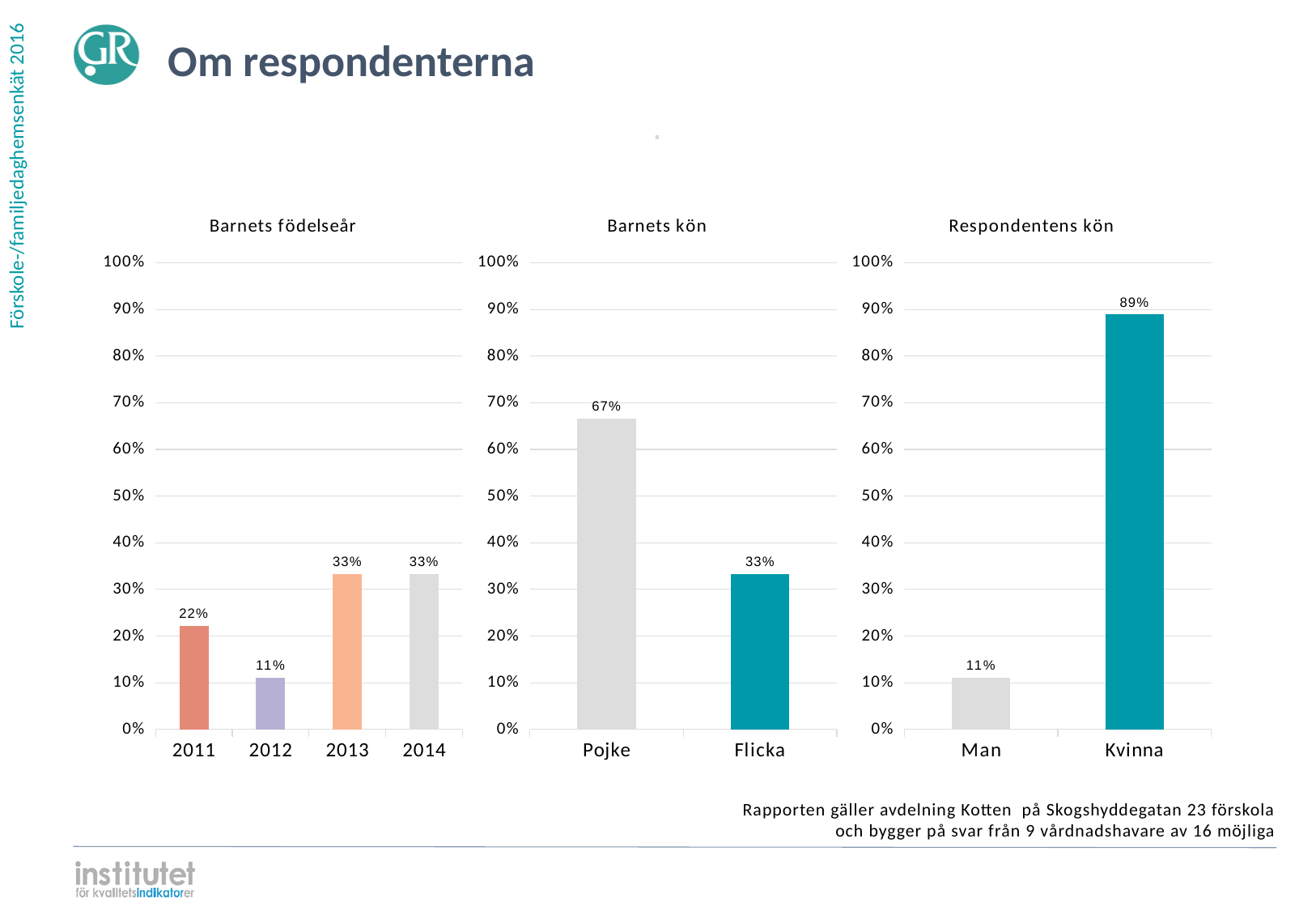
In the 'Barnets födelseår' chart, what is the difference between the values for 2013 and 2012? 22% In the 'Respondentens kön' chart, what is the value for Kvinna? 89% In the 'Barnets kön' chart, what is the difference between Pojke and Flicka? 34% In the 'Barnets kön' chart, which category is higher, Pojke or Flicka? Pojke In the 'Barnets födelseår' chart, which year has the lowest value? 2012 In the 'Respondentens kön' chart, which category has the highest value? Kvinna In the 'Respondentens kön' chart, what is the value for Man? 11% In the 'Barnets födelseår' chart, how many years are shown on the x axis? 4 How many charts are shown on the slide? 3 What kind of chart is the 'Respondentens kön' chart? Bar chart In the 'Barnets kön' chart, what is the value for Pojke? 67% In the 'Barnets födelseår' chart, what is the value for 2011? 22%